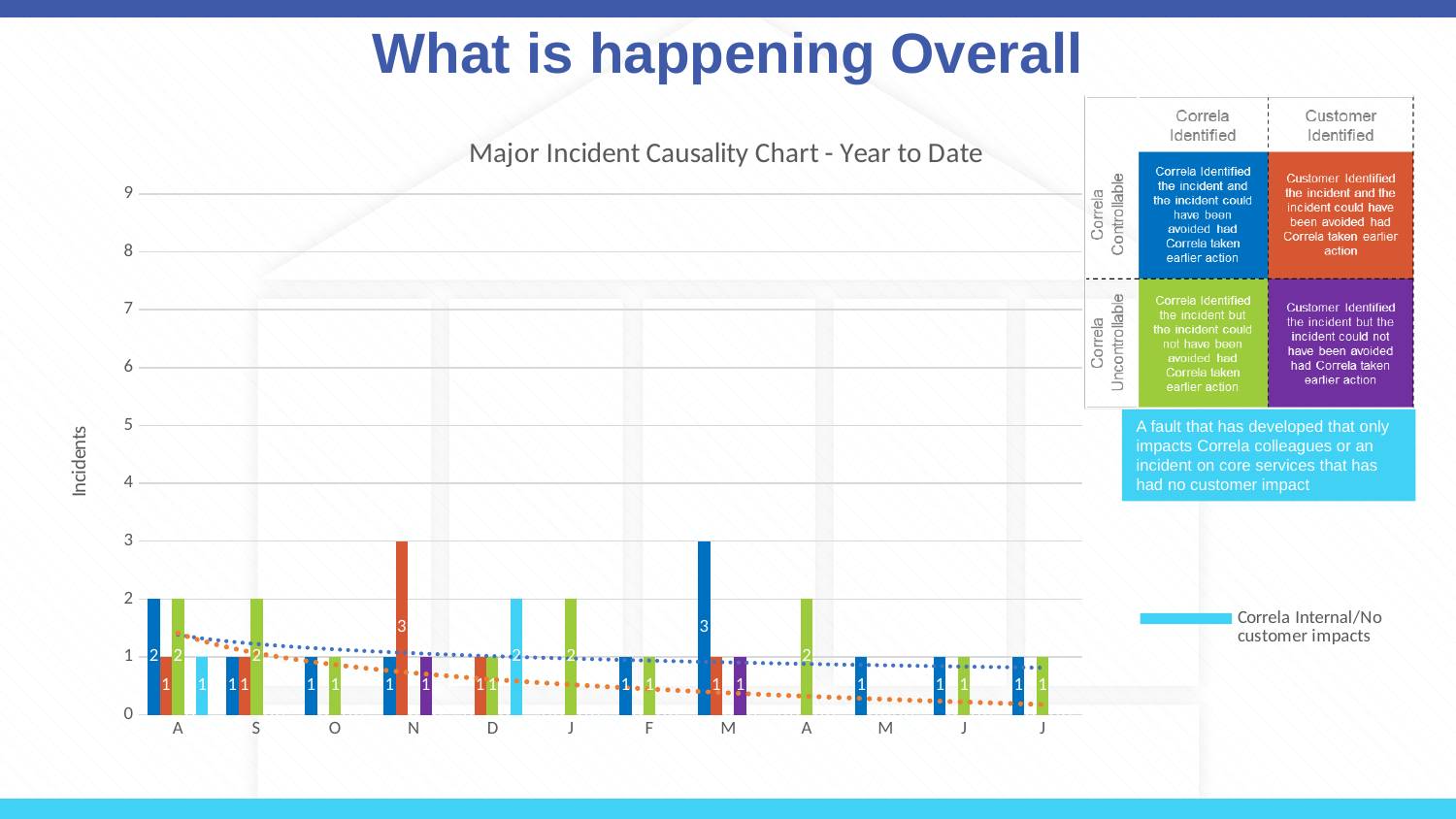
Do the dotted trend lines rise or fall from left to right across the chart? fall In which month is the orange bar at its highest? N Is the tallest bar on the chart greater or less than 4? less What kind of chart is the Major Incident Causality Chart? bar chart What is the label on the y axis of the chart? Incidents What is the difference between the orange bar and the dark blue bar in the month labelled N? 2 What is the value of the light blue bar in the month labelled D? 2 What is the value of the orange bar in the month labelled N? 3 How many months are shown along the x axis of the Major Incident Causality Chart? 12 What is the total of all bars in the month labelled N? 5 What is the title of the chart on the slide? Major Incident Causality Chart - Year to Date What is the value of the dark blue bar in the first month labelled M? 3